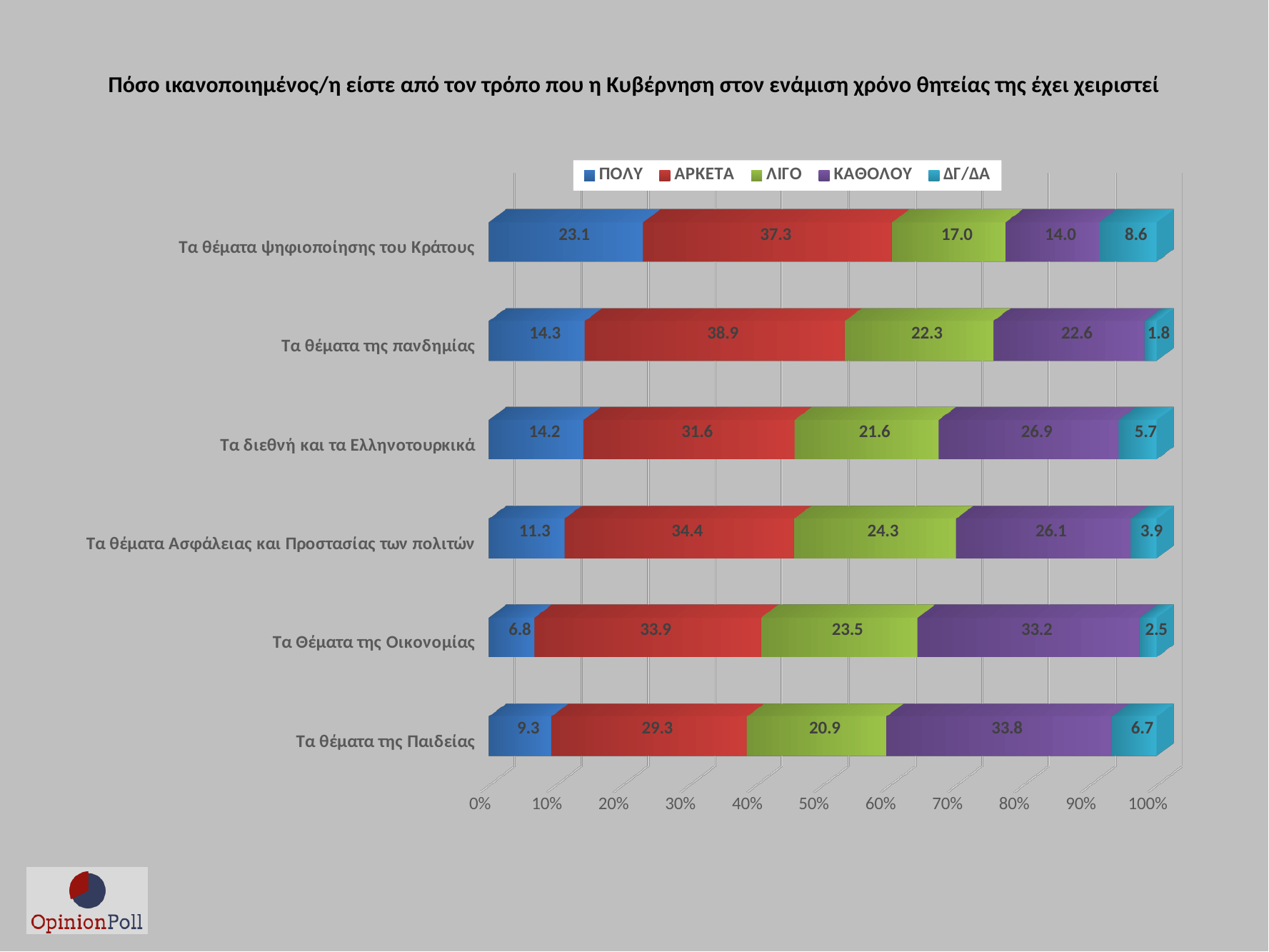
What type of chart is shown on the slide? Stacked bar chart Which category has the lowest ΠΟΛΥ value? Τα Θέματα της Οικονομίας How many categories (topics) are shown on the chart? 6 Which is larger for Τα θέματα της Παιδείας: the ΑΡΚΕΤΑ value or the ΚΑΘΟΛΟΥ value? ΚΑΘΟΛΟΥ What is the ΔΓ/ΔΑ value for Τα θέματα της πανδημίας? 1.8 What is the ΠΟΛΥ value for Τα θέματα ψηφιοποίησης του Κράτους? 23.1 Which series is shown in red in the legend? ΑΡΚΕΤΑ What is the difference between the ΠΟΛΥ values for Τα θέματα ψηφιοποίησης του Κράτους and Τα θέματα της πανδημίας? 8.8 What is the ΚΑΘΟΛΟΥ value for Τα Θέματα της Οικονομίας? 33.2 Which category has the highest ΑΡΚΕΤΑ value? Τα θέματα της πανδημίας Which category has the highest ΠΟΛΥ value? Τα θέματα ψηφιοποίησης του Κράτους How many series does the legend list? 5